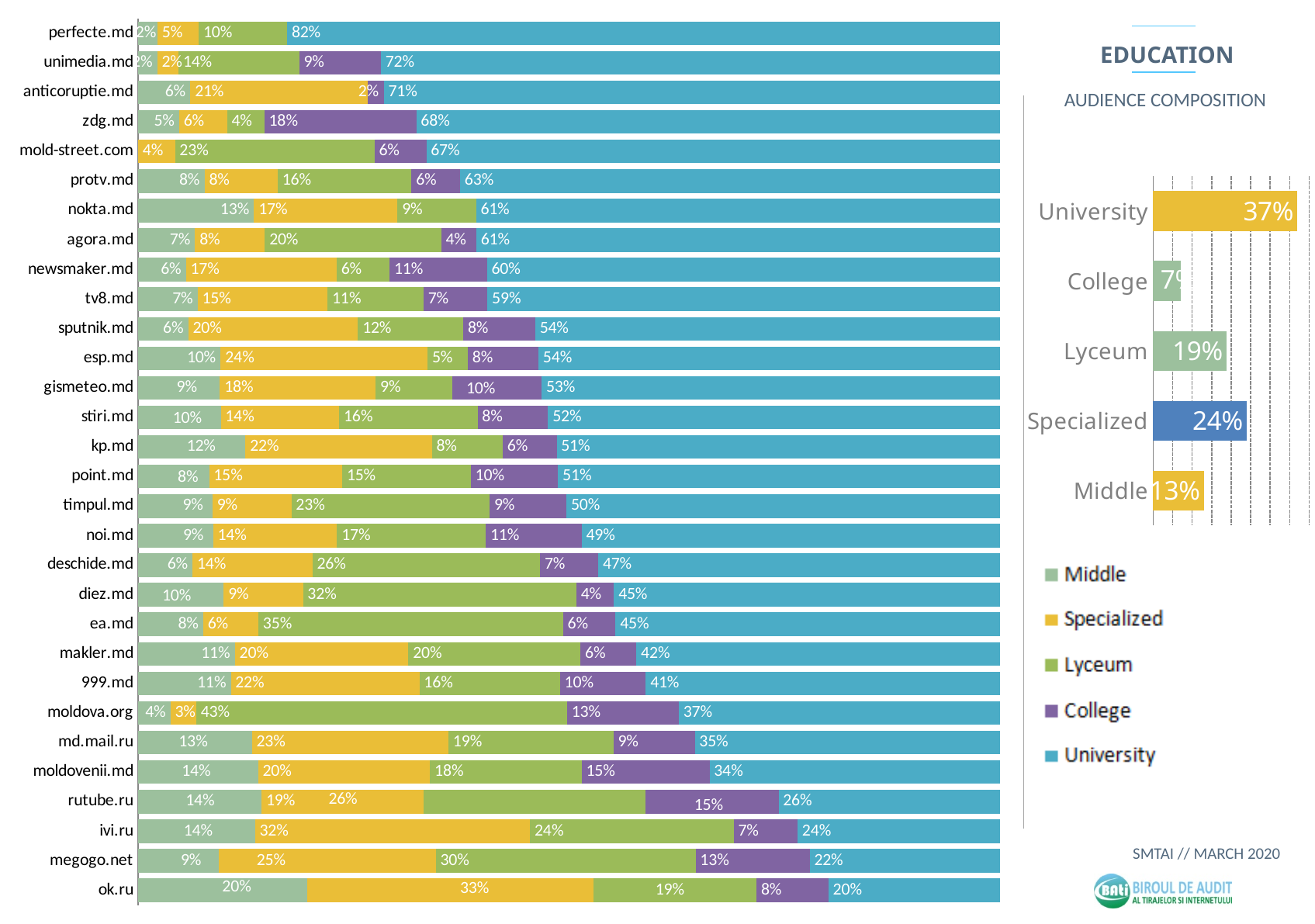
In the left stacked bar chart, what is the University share for perfecte.md? 82% In the Audience Composition chart on the right, which category has the lowest value? College How many series does the legend of the left stacked bar chart list? 5 In the left stacked bar chart, what is the difference in University share between perfecte.md and ok.ru? 62 percentage points How many websites are listed in the left stacked bar chart? 30 In the left stacked bar chart, which website has the lowest University share? ok.ru In the left stacked bar chart, what is the Specialized share for ok.ru? 33% In the left stacked bar chart, what is the Lyceum share for moldova.org? 43% In the left stacked bar chart, which has a larger University share, sputnik.md or diez.md? sputnik.md What kind of chart is the Audience Composition chart on the right? Bar chart In the left stacked bar chart, which website has the highest University share? perfecte.md In the Audience Composition chart on the right, what is the value for University? 37%